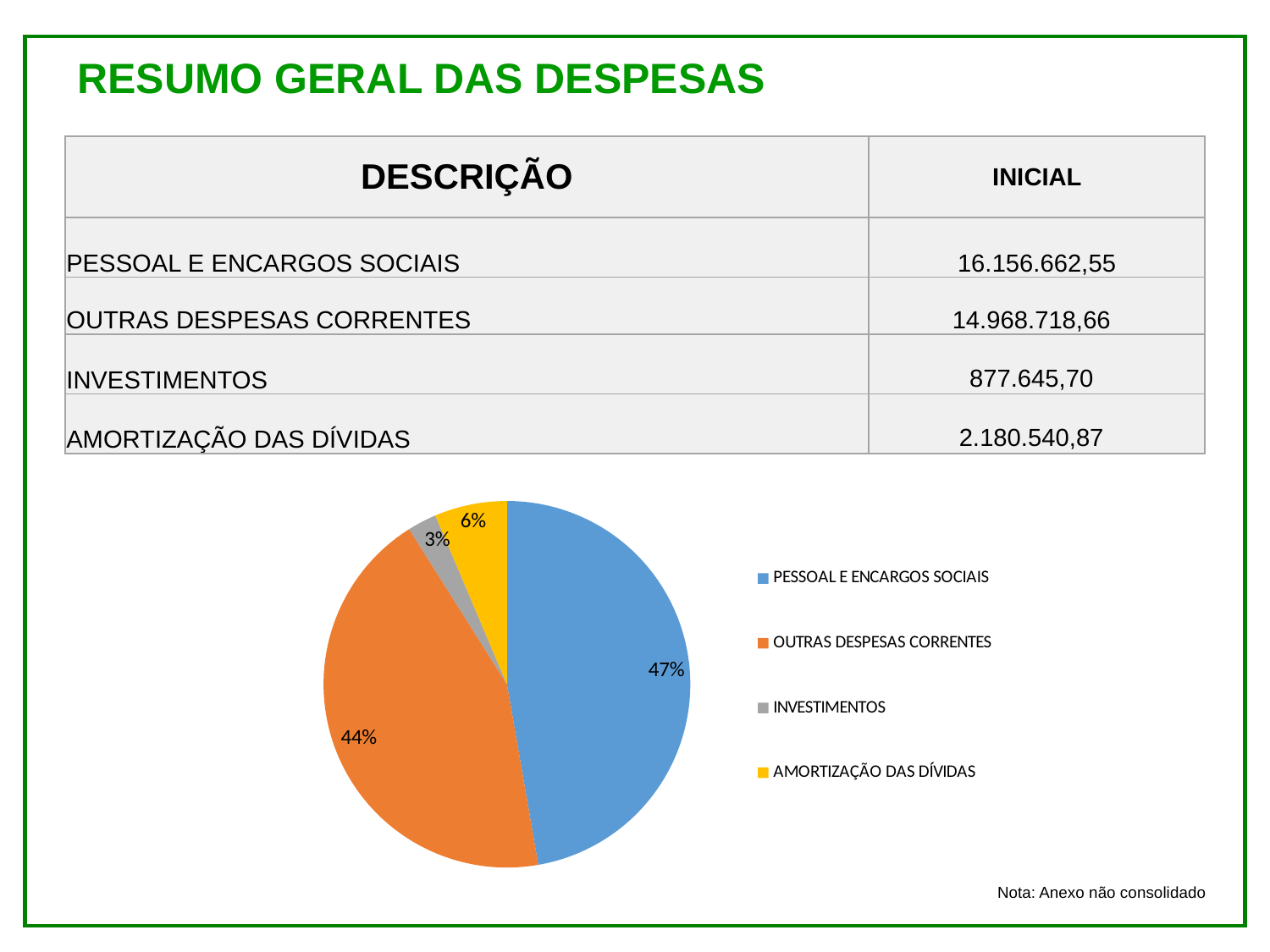
Which is larger, the slice for AMORTIZAÇÃO DAS DÍVIDAS or the slice for INVESTIMENTOS? AMORTIZAÇÃO DAS DÍVIDAS How many categories does the pie chart show? 4 What colour is the slice for AMORTIZAÇÃO DAS DÍVIDAS? yellow What share of the pie does INVESTIMENTOS represent? 3% Which category has the smallest slice of the pie? INVESTIMENTOS What is the difference in percentage points between the PESSOAL E ENCARGOS SOCIAIS slice and the OUTRAS DESPESAS CORRENTES slice? 3% Which category has the largest slice of the pie? PESSOAL E ENCARGOS SOCIAIS What share of the pie does OUTRAS DESPESAS CORRENTES represent? 44% What colour is the slice for OUTRAS DESPESAS CORRENTES? orange What share of the pie does PESSOAL E ENCARGOS SOCIAIS represent? 47% What kind of chart is shown on the slide? pie chart